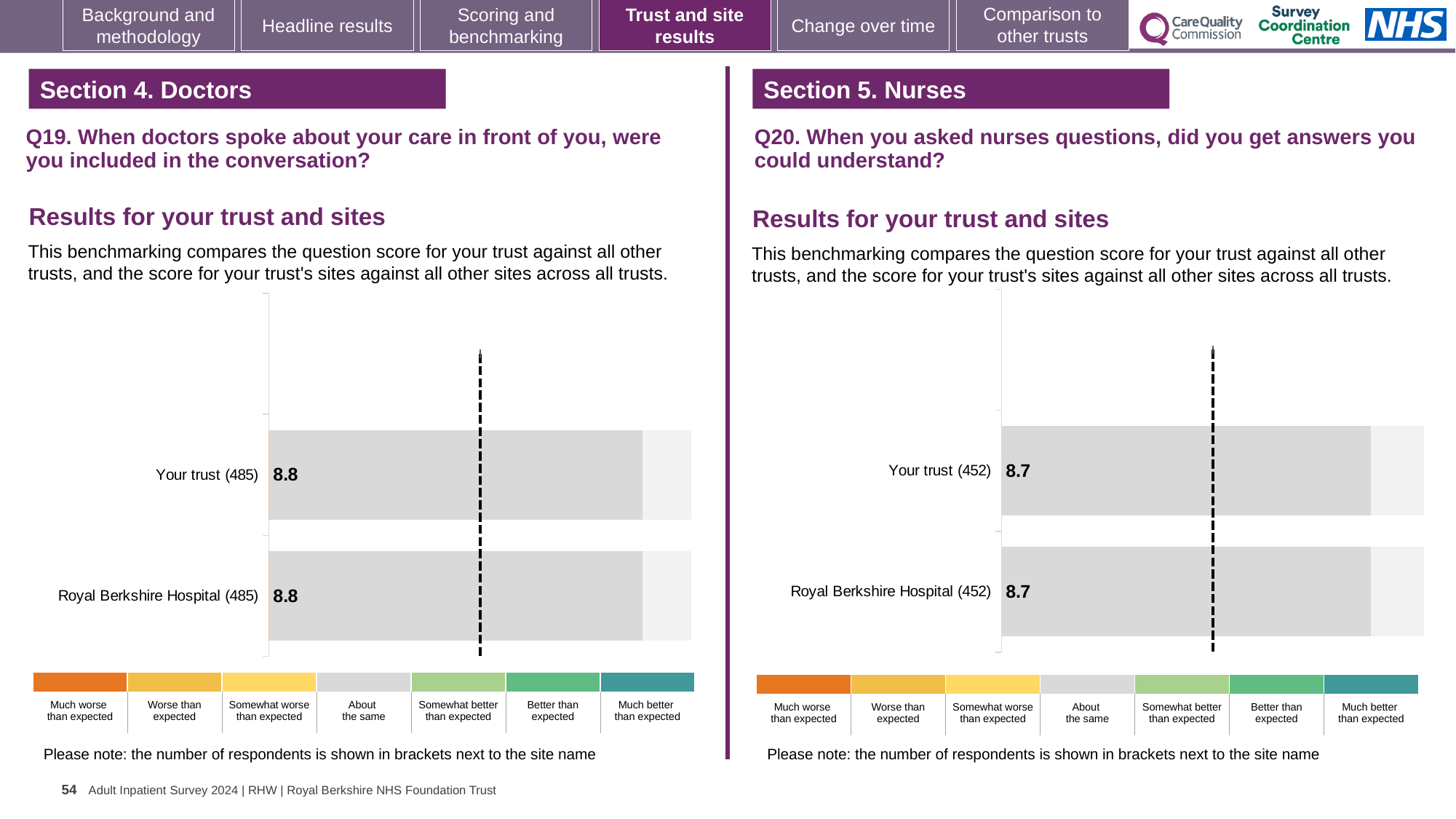
On the Q20 chart (Section 5. Nurses), how many respondents are shown in brackets next to Royal Berkshire Hospital? 452 On the Q20 chart (Section 5. Nurses), what is the difference between the score for Your trust and the score for Royal Berkshire Hospital? 0 On the Q19 chart (Section 4. Doctors), what is the score for Your trust? 8.8 On the Q19 chart (Section 4. Doctors), what is the score for Royal Berkshire Hospital? 8.8 How many bars are plotted on the Q19 chart (Section 4. Doctors)? 2 Is the score for Your trust on the Q19 chart (Section 4. Doctors) larger or smaller than the score for Your trust on the Q20 chart (Section 5. Nurses)? Larger What kind of chart is used on the Q19 chart (Section 4. Doctors)? Bar chart On the Q20 chart (Section 5. Nurses), what is the score for Your trust? 8.7 On the Q19 chart (Section 4. Doctors), how many respondents are shown in brackets next to Your trust? 485 On the Q20 chart (Section 5. Nurses), what is the score for Royal Berkshire Hospital? 8.7 On the Q19 chart (Section 4. Doctors), what is the difference between the score for Your trust and the score for Royal Berkshire Hospital? 0 How many bars are plotted on the Q20 chart (Section 5. Nurses)? 2